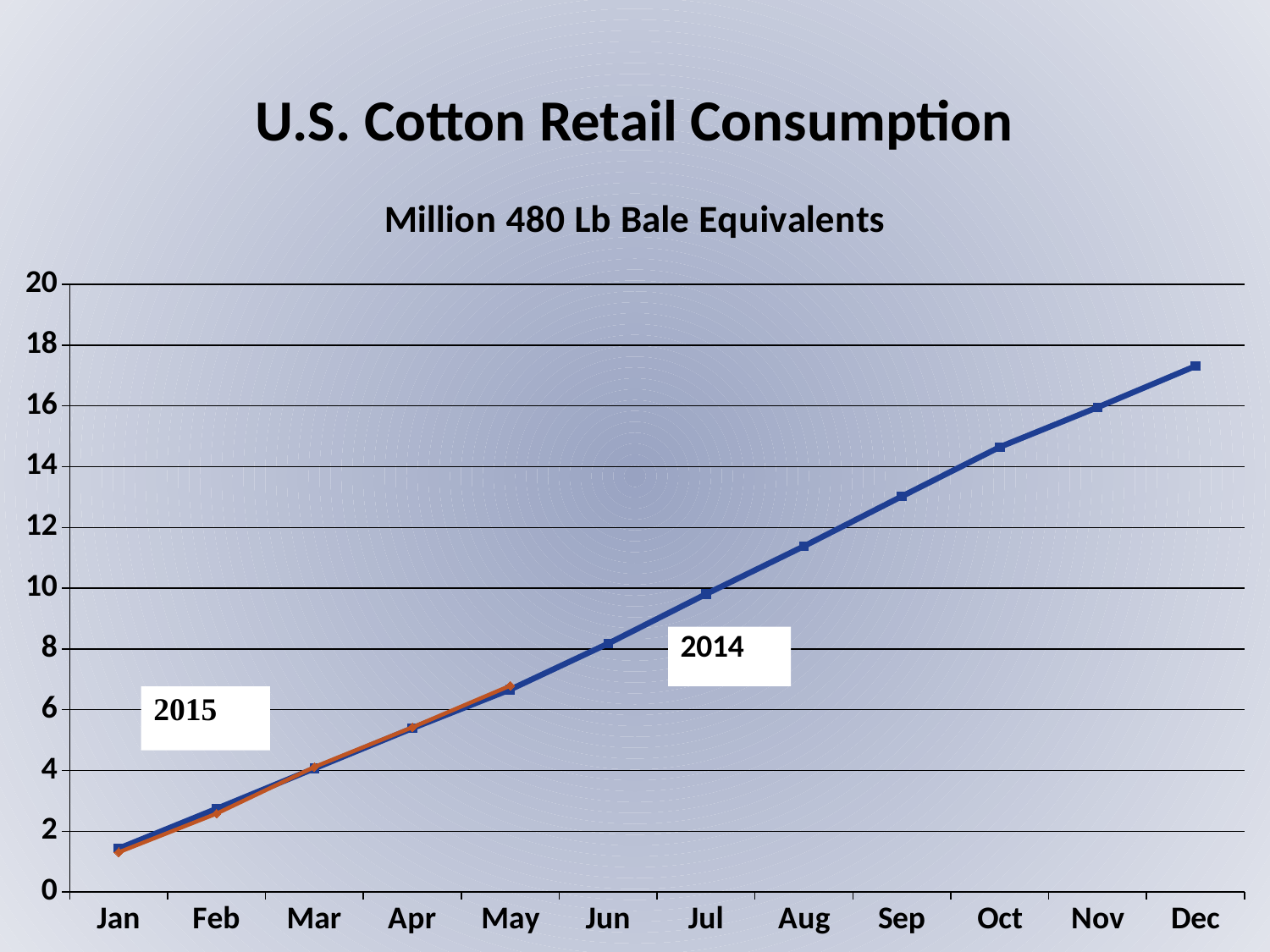
Do the values of the 2014 series rise or fall from Jan to Dec? rise Is the value for Sep in the 2014 series greater or less than 12? greater Is the value for Jan in the 2014 series greater or less than 2? less Which month has the lowest value for the 2014 series? Jan In what units are the values on the chart expressed, according to the subtitle? Million 480 Lb Bale Equivalents What is the title of the chart? U.S. Cotton Retail Consumption What kind of chart is shown on the slide? line chart How many months are shown along the x axis? 12 Is the value for Apr in the 2015 series greater or less than 4? greater How many series are plotted on the chart? 2 Which month has the highest value for the 2014 series? Dec